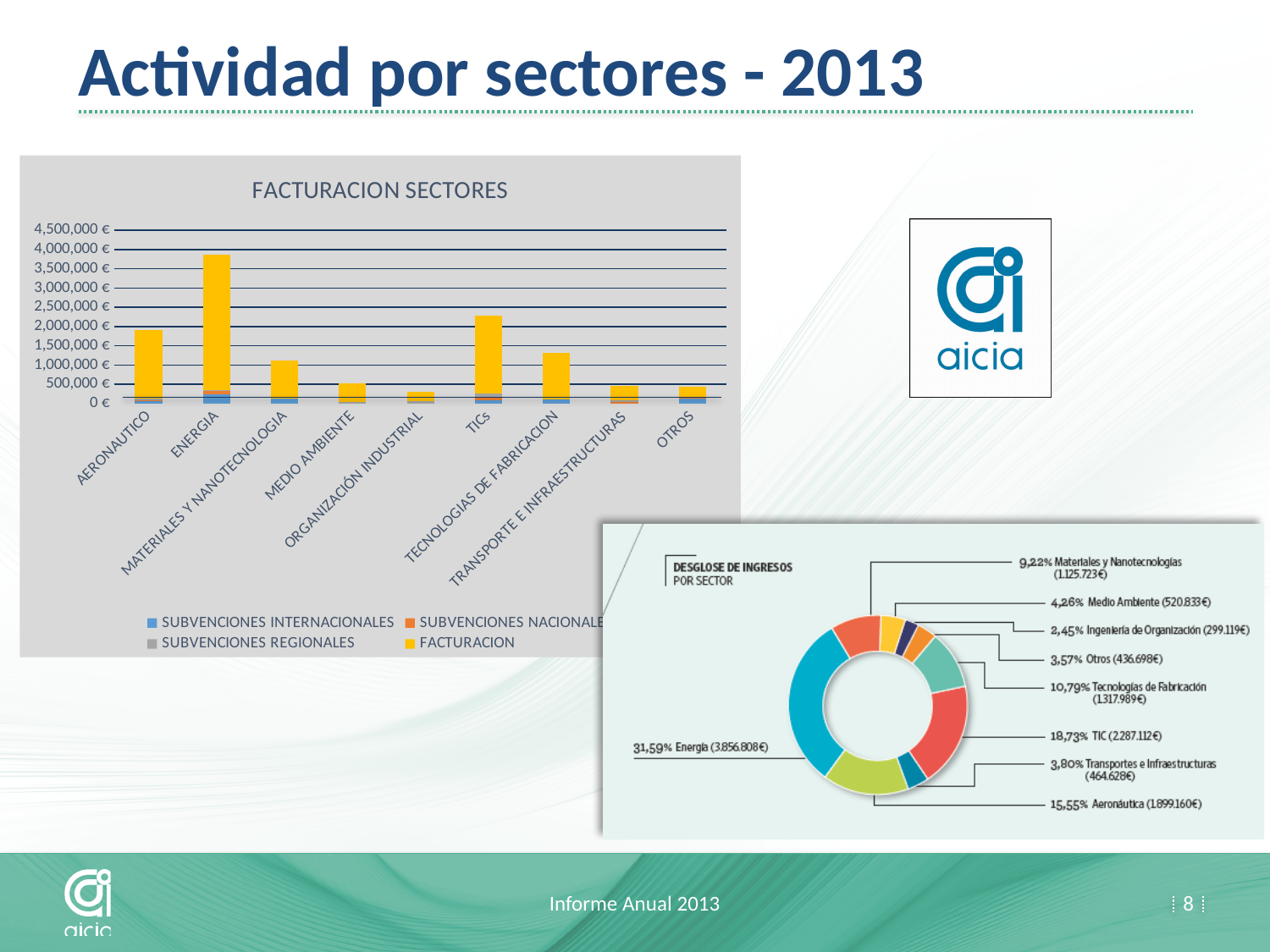
In the 'DESGLOSE DE INGRESOS POR SECTOR' donut chart, which sector has the smallest share? Ingeniería de Organización In the 'FACTURACION SECTORES' chart, which sector has the tallest bar? ENERGIA In the 'FACTURACION SECTORES' chart, which bar is taller, TICs or AERONAUTICO? TICs In the 'DESGLOSE DE INGRESOS POR SECTOR' donut chart, what share does Energia have? 31,59% In the 'FACTURACION SECTORES' chart, is the total bar for MEDIO AMBIENTE greater or less than 1,000,000 €? less In the 'FACTURACION SECTORES' chart, which sector has the shortest bar? ORGANIZACIÓN INDUSTRIAL In the 'DESGLOSE DE INGRESOS POR SECTOR' donut chart, what is the value shown for TIC? 2.287.112€ What kind of chart is the 'FACTURACION SECTORES' chart? Bar chart In the 'FACTURACION SECTORES' chart, how many sector categories are shown on the x axis? 9 In the 'FACTURACION SECTORES' chart, how many series does the legend list? 4 In the 'DESGLOSE DE INGRESOS POR SECTOR' donut chart, what is the difference in percentage points between Aeronáutica and Tecnologías de Fabricación? 4,76 In the 'FACTURACION SECTORES' chart, is the total bar for ENERGIA greater or less than 3,500,000 €? greater